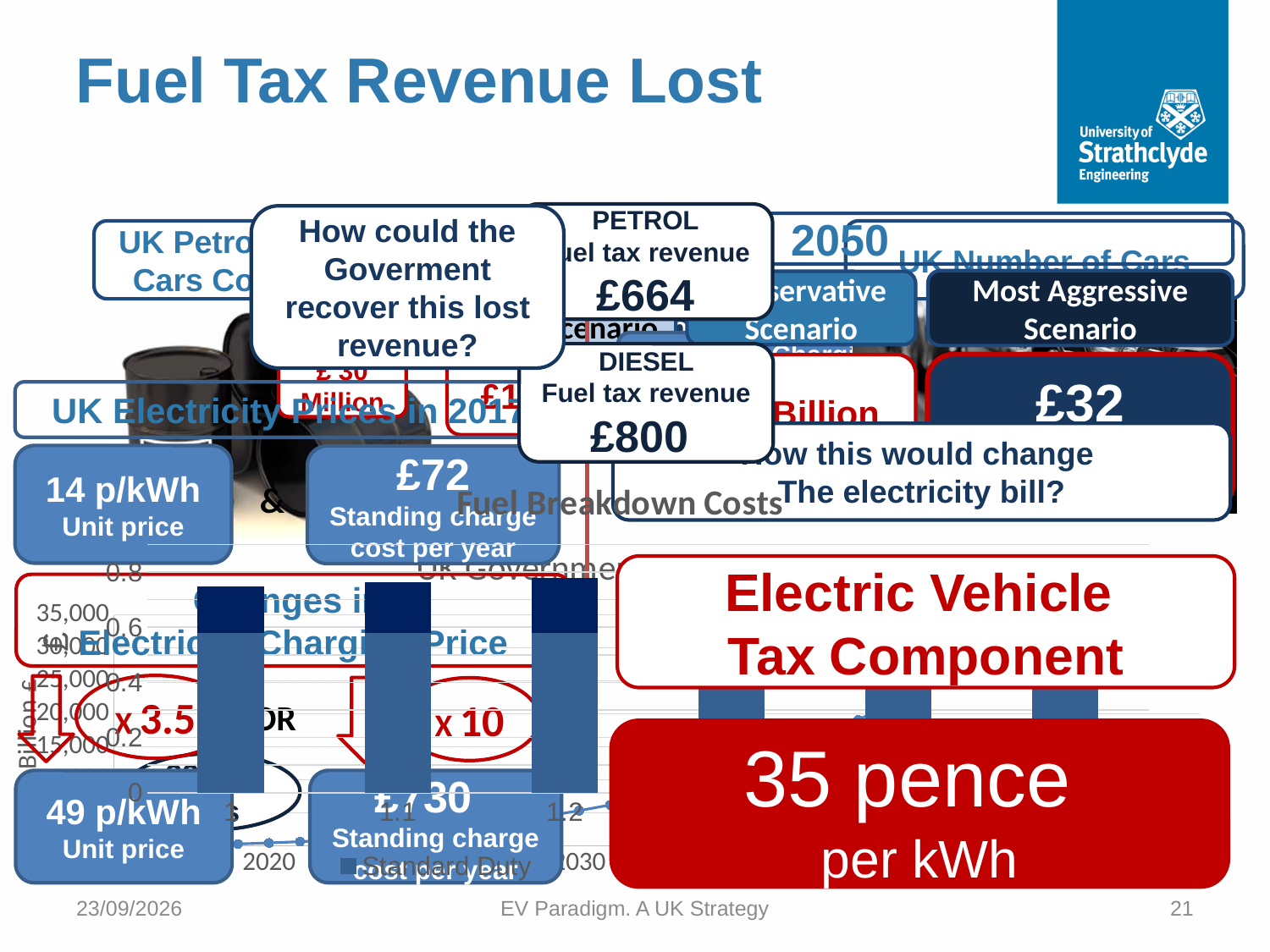
What is the highest tick value shown on the y axis of the 'Fuel Breakdown Costs' chart? 0.8 In the 'Fuel Breakdown Costs' chart, is the value of the bar labelled 1.1 greater or less than 0.2? greater What is the title of the bar chart in the lower-left area of the slide? Fuel Breakdown Costs In the 'Fuel Breakdown Costs' chart, is the total value of the bar labelled 1.2 greater or less than 0.6? greater What kind of chart is the 'Fuel Breakdown Costs' chart? bar chart In the 'Fuel Breakdown Costs' chart, is the total value of the bar labelled 1.1 greater or less than 0.4? greater